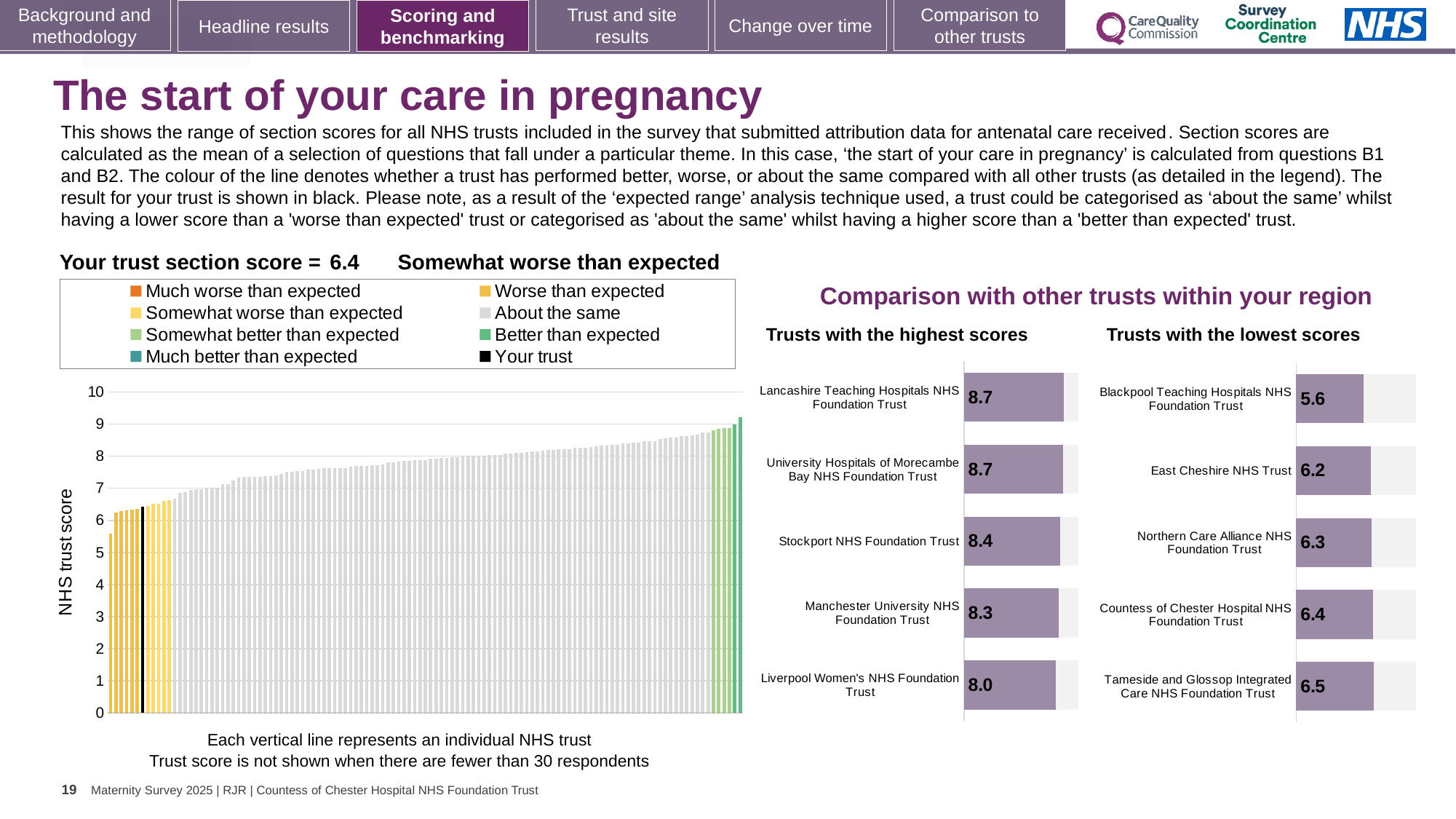
In the 'Trusts with the highest scores' chart, which has the higher score: Stockport NHS Foundation Trust or Manchester University NHS Foundation Trust? Stockport NHS Foundation Trust How many trusts are listed in the 'Trusts with the lowest scores' chart? 5 In the 'Trusts with the lowest scores' chart, what is the difference between the scores of Tameside and Glossop Integrated Care NHS Foundation Trust and Blackpool Teaching Hospitals NHS Foundation Trust? 0.9 In the 'Trusts with the highest scores' chart, which trust has the lowest score shown? Liverpool Women's NHS Foundation Trust In the 'Trusts with the lowest scores' chart, what is the score for Blackpool Teaching Hospitals NHS Foundation Trust? 5.6 What kind of chart is the 'NHS trust score' chart on the left of the slide? Bar chart In the 'NHS trust score' chart on the left, do the bar values rise or fall from left to right? Rise In the 'Trusts with the highest scores' chart, what is the score for Stockport NHS Foundation Trust? 8.4 In the 'Trusts with the lowest scores' chart, which trust has the lowest score? Blackpool Teaching Hospitals NHS Foundation Trust In the 'NHS trust score' chart on the left, is the value of the leftmost bar greater or less than 6? less In the 'Trusts with the lowest scores' chart, what is the score for Countess of Chester Hospital NHS Foundation Trust? 6.4 In the 'Trusts with the highest scores' chart, what is the score for Liverpool Women's NHS Foundation Trust? 8.0